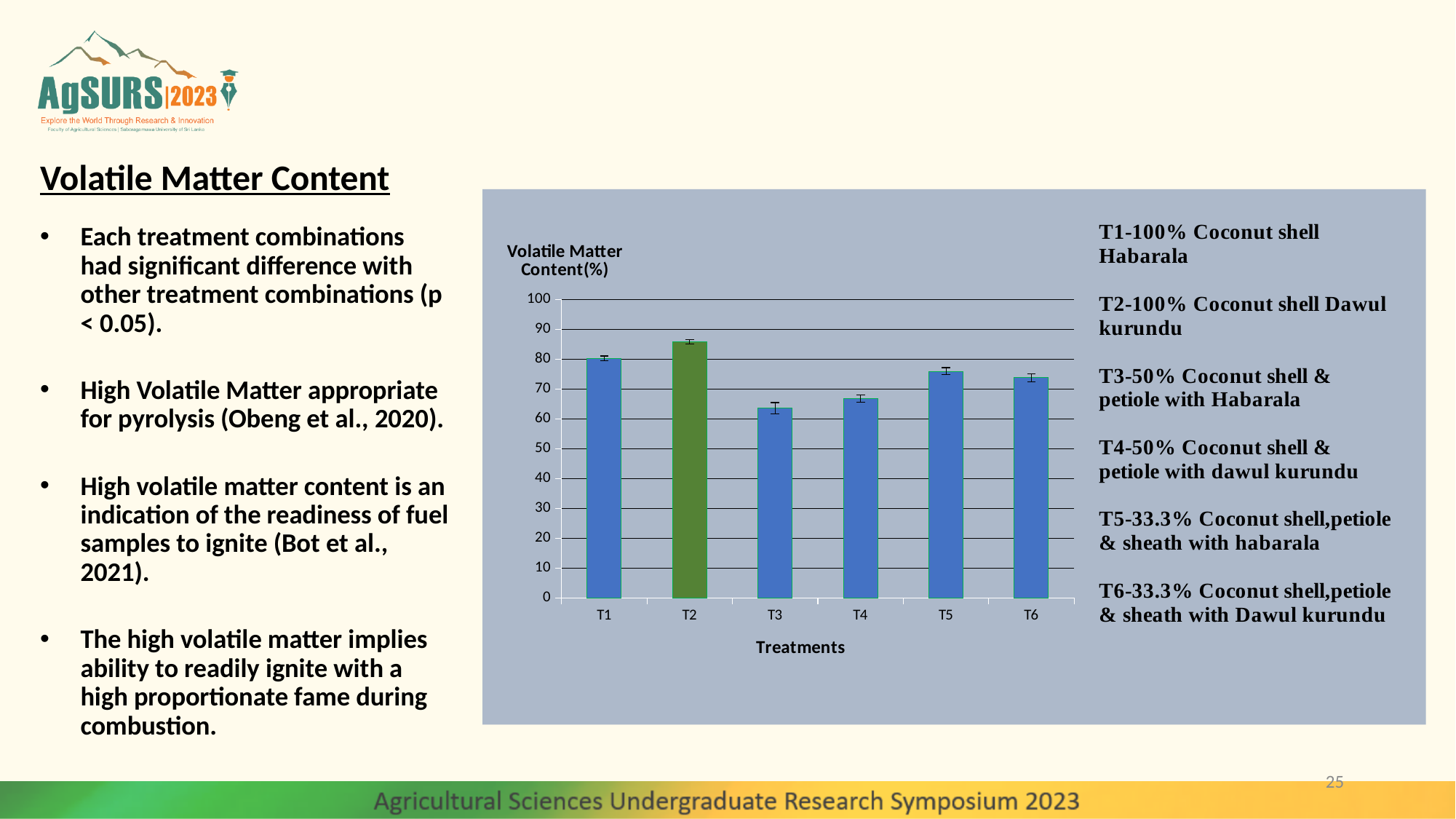
Which has a higher volatile matter content, T6 or T2? T2 What kind of chart is shown on the slide? bar chart Is the volatile matter content for T5 greater or less than 70? greater What is the title of the x axis of the chart? Treatments Which has a higher volatile matter content, T1 or T3? T1 Is the volatile matter content for T2 greater or less than 80? greater Which treatment has the highest volatile matter content? T2 Which treatment's bar is coloured green rather than blue? T2 Is the volatile matter content for T4 greater or less than 70? less Which treatment has the lowest volatile matter content? T3 How many treatments are plotted on the x axis of the chart? 6